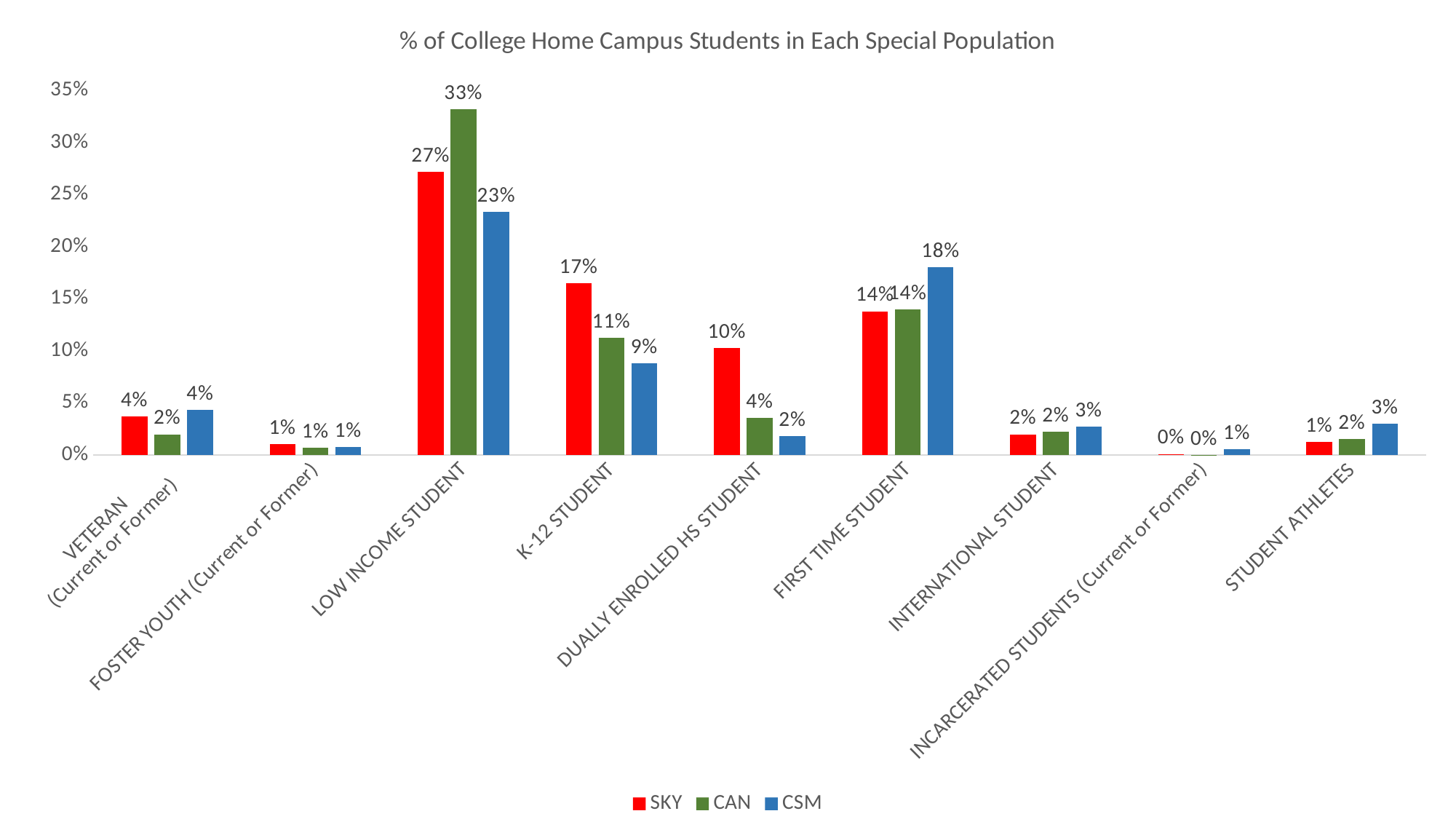
What is the CAN value for LOW INCOME STUDENT? 33% Which category has the lowest SKY value? INCARCERATED STUDENTS (Current or Former) How many categories are shown on the x axis? 9 Is the SKY value for LOW INCOME STUDENT greater or less than 25%? greater For K-12 STUDENT, which is larger: the SKY value or the CAN value? SKY What is the CSM value for FIRST TIME STUDENT? 18% Which category has the highest CSM value? LOW INCOME STUDENT What is the difference between the CAN and CSM values for LOW INCOME STUDENT? 10% What is the difference between the SKY and CSM values for K-12 STUDENT? 8% How many series does the legend list? 3 What type of chart is shown on the slide? Bar chart What is the SKY value for DUALLY ENROLLED HS STUDENT? 10%